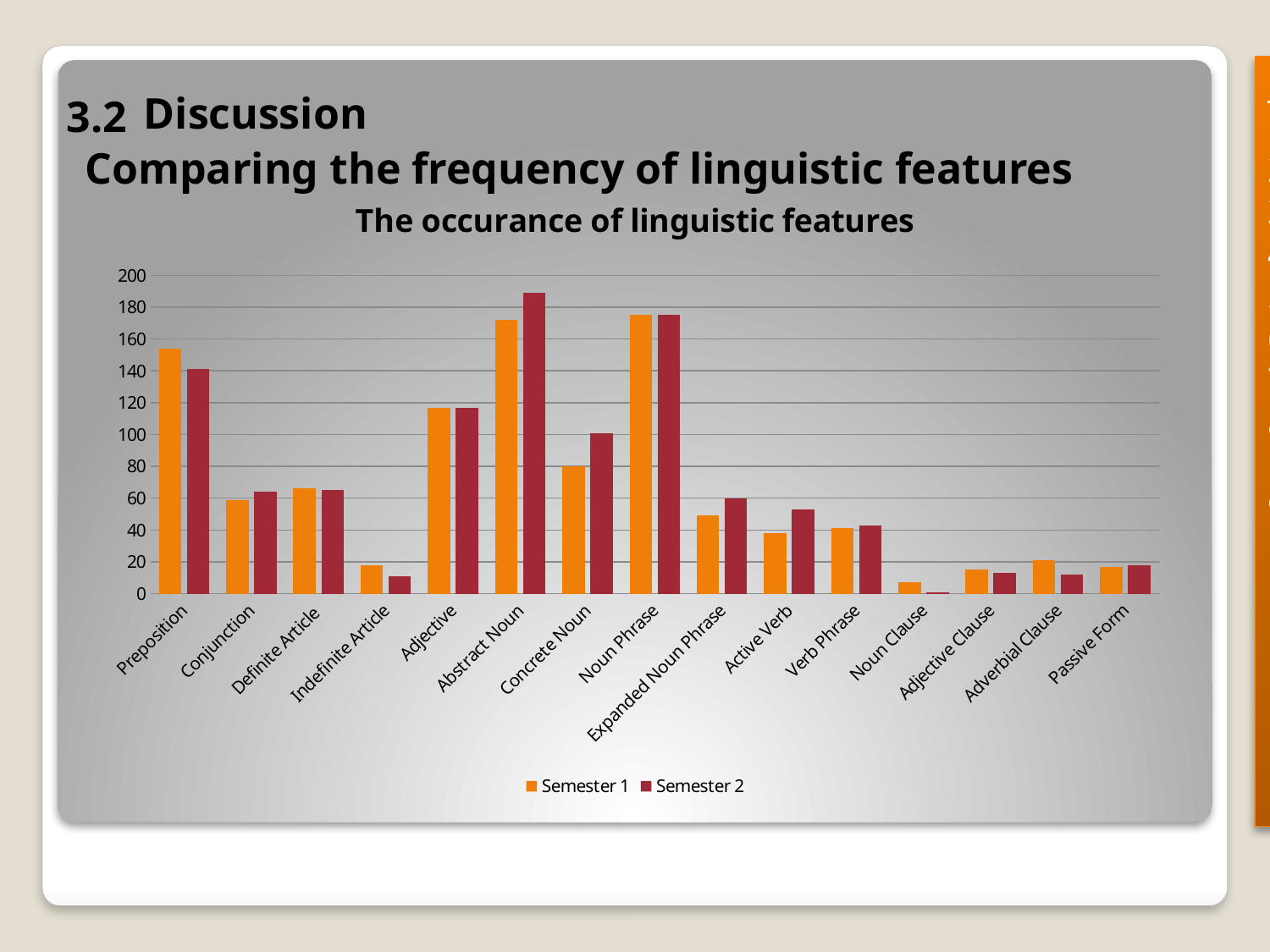
Is the Semester 1 value for Preposition greater or less than 140? greater Which is larger for Concrete Noun, the Semester 1 value or the Semester 2 value? Semester 2 How many series does the legend list? 2 What kind of chart is shown on the slide? bar chart Is the Semester 2 value for Indefinite Article greater or less than 20? less What is the title of the chart? The occurance of linguistic features Which category has the lowest Semester 2 value? Noun Clause Which category has the highest Semester 2 value? Abstract Noun Is the Semester 2 value for Abstract Noun greater or less than 180? greater Which is larger for Preposition, the Semester 1 value or the Semester 2 value? Semester 1 Which colour represents Semester 1 in the chart? orange How many linguistic feature categories are shown on the x axis? 15